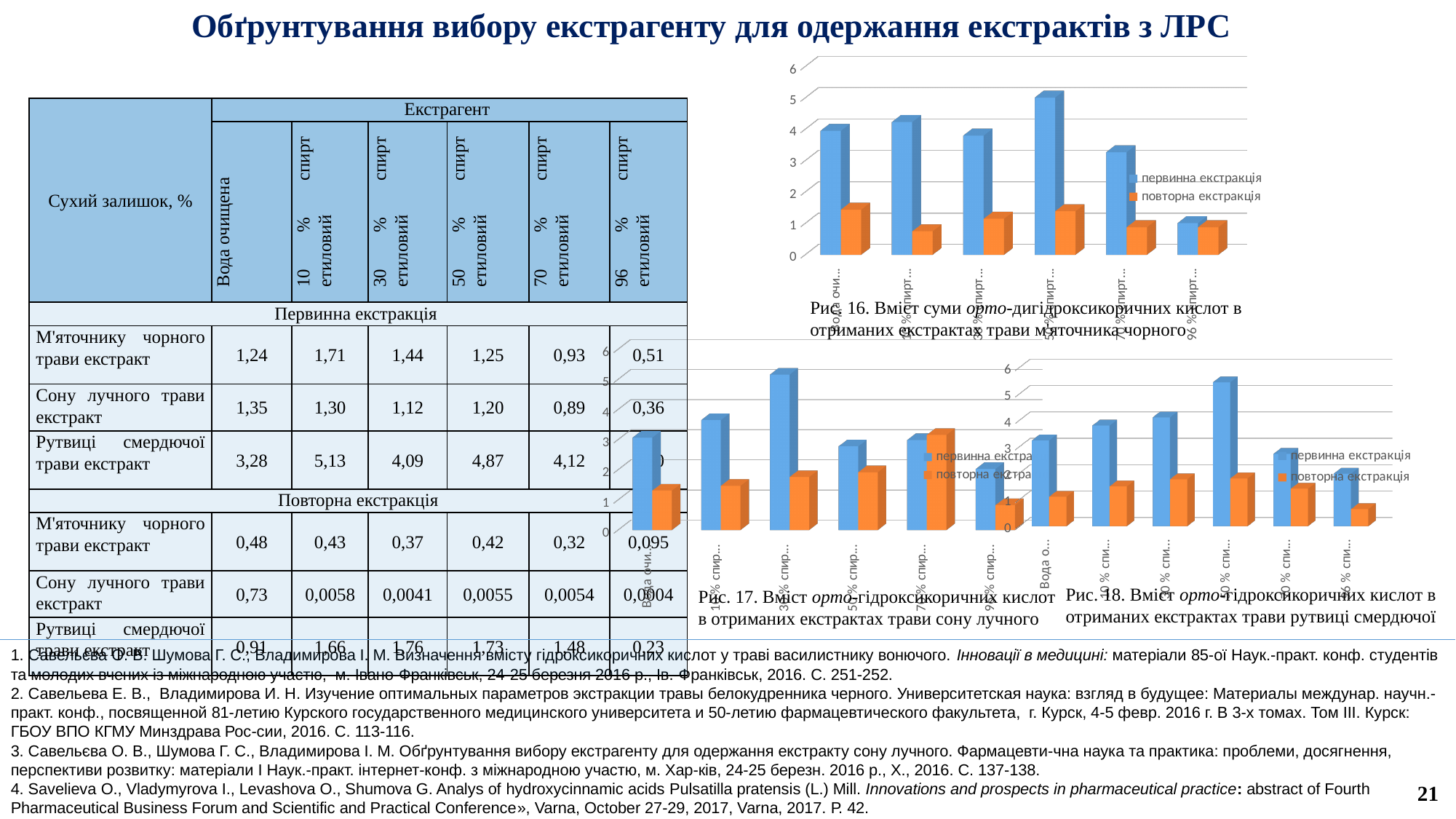
How many series does the legend of Рис. 17 list? 2 In Рис. 18, which category has the highest первинна екстракція bar? 50 % спирт In Рис. 16, which category has the lowest первинна екстракція bar? 96 % спирт In Рис. 16, what colour are the повторна екстракція bars? orange How many categories are plotted along the x axis of Рис. 18? 6 In Рис. 17, is the первинна екстракція value for 30 % спирт greater or less than 5? greater In Рис. 16, which category has the highest первинна екстракція bar? 50 % спирт What kind of chart is Рис. 16 (top right)? bar chart In Рис. 18, which is larger for 50 % спирт: первинна екстракція or повторна екстракція? первинна екстракція In Рис. 17, which category has the highest первинна екстракція bar? 30 % спирт In Рис. 16, is the первинна екстракція value for 50 % спирт greater or less than 4? greater In Рис. 18, is the повторна екстракція value for 96 % спирт greater or less than 2? less